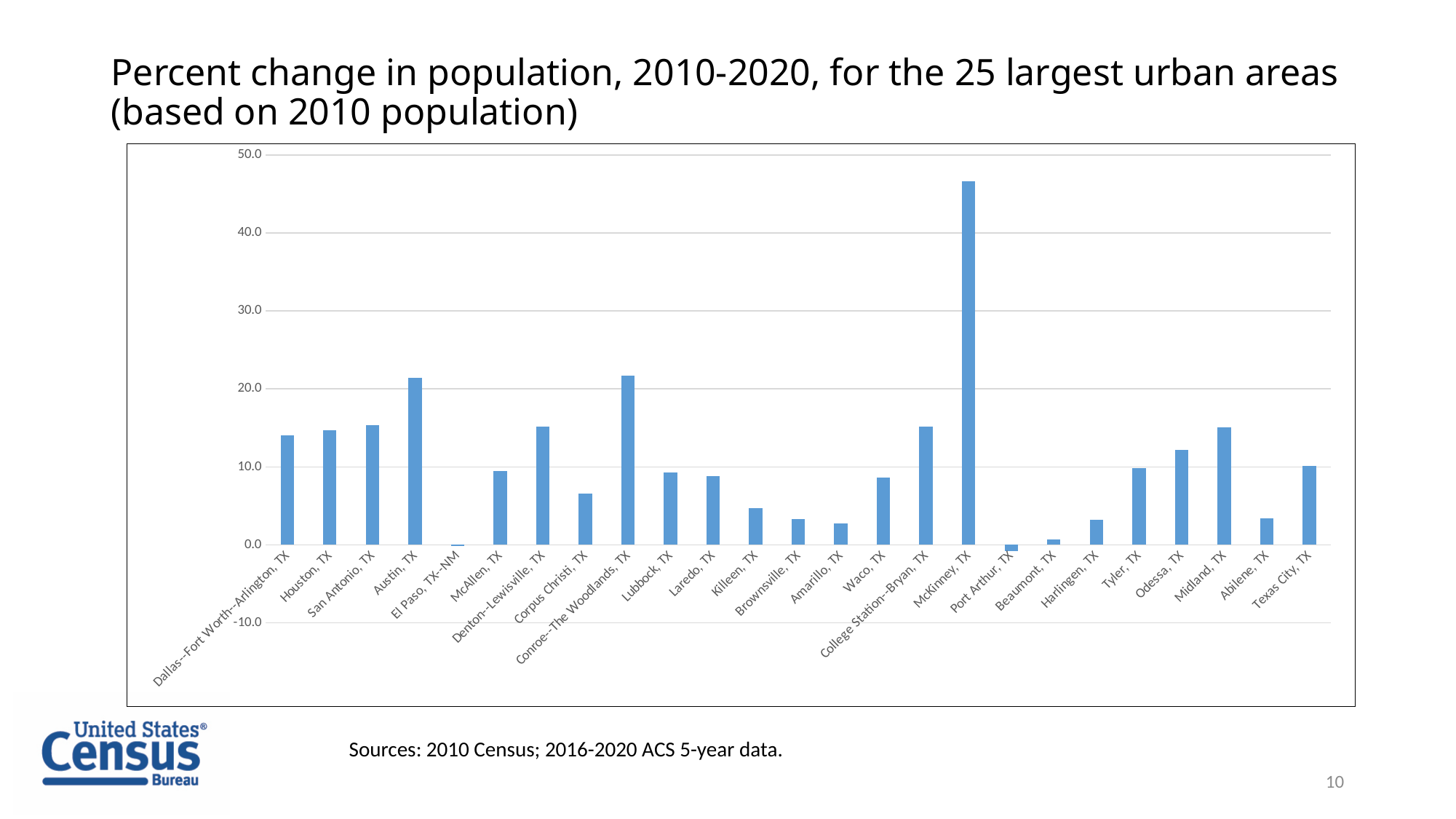
Is the value for Houston, TX greater or less than 20.0? less Is the value for Austin, TX greater or less than 20.0? greater What is the title of the slide's chart? Percent change in population, 2010-2020, for the 25 largest urban areas (based on 2010 population) Which urban area has the highest percent change in population? McKinney, TX Is the value for McKinney, TX greater or less than 40.0? greater What kind of chart is shown on the slide? Bar chart Which has a larger percent change in population, Lubbock, TX or Corpus Christi, TX? Lubbock, TX How many urban areas are plotted in the chart? 25 Which urban area has the lowest percent change in population? Port Arthur, TX Which has a larger percent change in population, Austin, TX or Houston, TX? Austin, TX